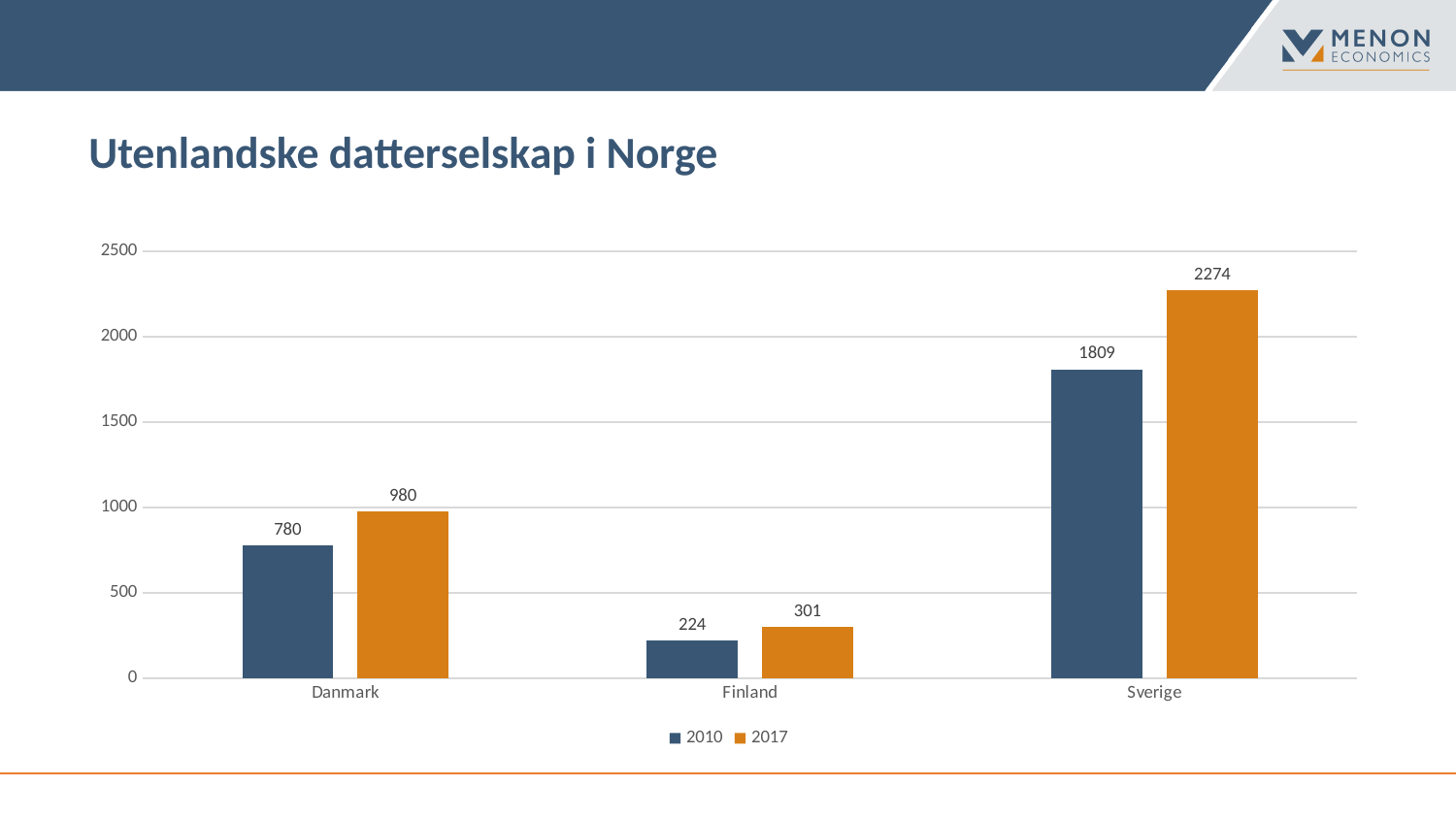
How many series does the legend list? 2 Which country has the lowest value in 2017? Finland Which country has the highest value in 2010? Sverige What is the value for Sverige in 2017? 2274 Which is larger: the 2010 value for Danmark or the 2017 value for Finland? 2010 value for Danmark What is the difference between the 2017 and 2010 values for Sverige? 465 Is the 2010 value for Sverige greater or less than 2000? less What is the difference between the 2017 and 2010 values for Danmark? 200 How many countries are shown on the x axis? 3 What kind of chart is shown on the slide? bar chart What is the value for Danmark in 2010? 780 What is the value for Finland in 2017? 301